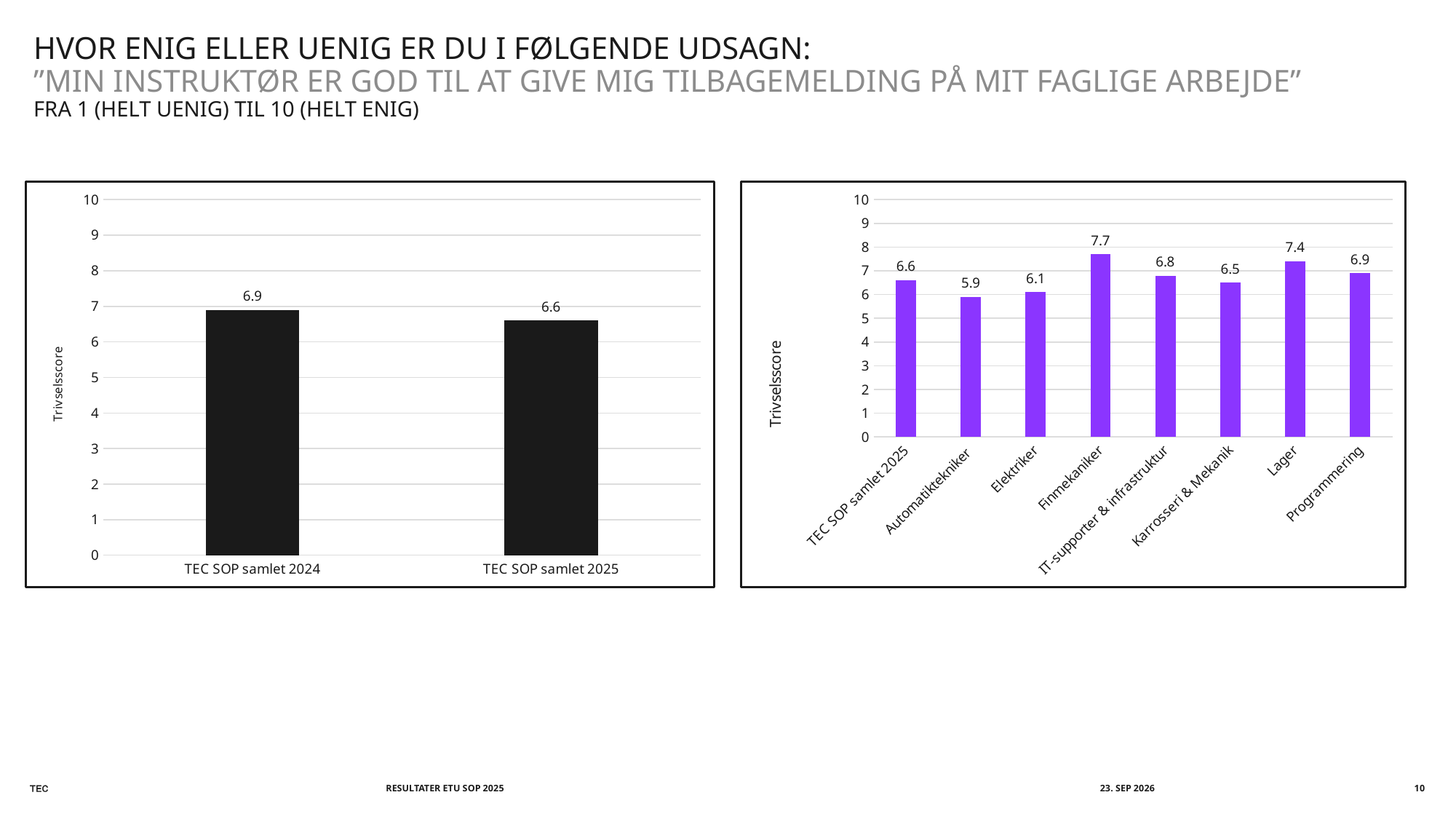
In the right chart, which is larger, Lager or Programmering? Lager In the left chart, what is the value for TEC SOP samlet 2024? 6.9 How many categories are shown in the right chart? 8 In the right chart, what is the value for Automatiktekniker? 5.9 In the right chart, which category has the lowest value? Automatiktekniker In the right chart, which category has the highest value? Finmekaniker What kind of chart is the right chart? bar chart In the left chart, do the values rise or fall from 2024 to 2025? fall In the left chart, what is the value for TEC SOP samlet 2025? 6.6 In the right chart, what is the value for Finmekaniker? 7.7 In the left chart, what is the difference between TEC SOP samlet 2024 and TEC SOP samlet 2025? 0.3 In the right chart, what is the difference between Finmekaniker and Elektriker? 1.6